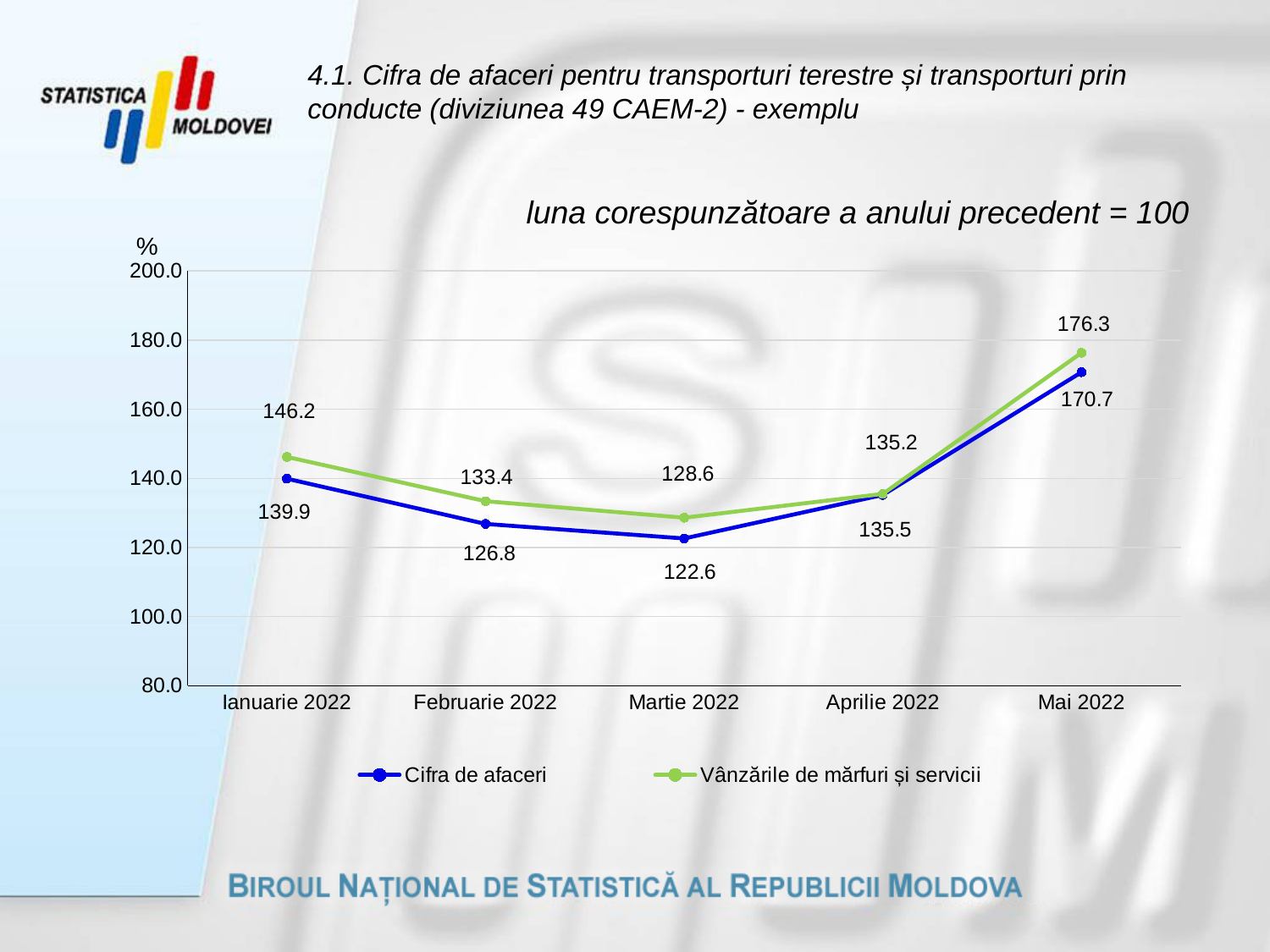
What is the value of Cifra de afaceri for Martie 2022? 122.6 By how much does Cifra de afaceri in Ianuarie 2022 exceed Cifra de afaceri in Martie 2022? 17.3 How many months are shown on the x axis? 5 Does Cifra de afaceri rise or fall from Martie 2022 to Mai 2022? rise In which month is Vânzările de mărfuri și servicii highest? Mai 2022 In Ianuarie 2022, which series has the higher value? Vânzările de mărfuri și servicii What kind of chart is shown on the slide? line chart What is the difference between Vânzările de mărfuri și servicii and Cifra de afaceri in Mai 2022? 5.6 In which month is Cifra de afaceri lowest? Martie 2022 What is the value of Vânzările de mărfuri și servicii for Mai 2022? 176.3 What is the value of Cifra de afaceri for Ianuarie 2022? 139.9 How many series does the legend list? 2